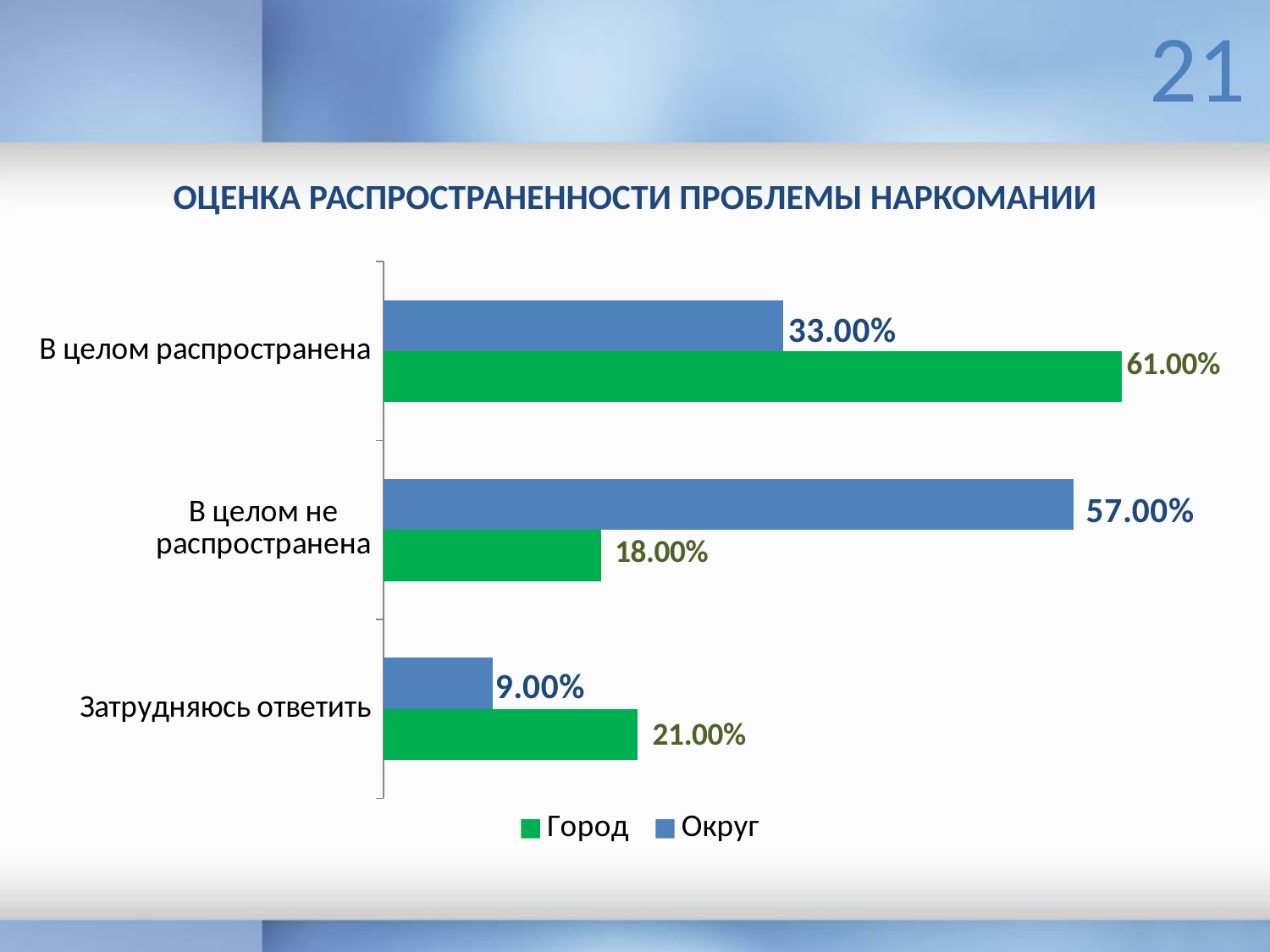
What is the value for Город in the category 'Затрудняюсь ответить'? 21.00% How many categories are shown on the chart? 3 Which category has the lowest value for the Округ series? Затрудняюсь ответить Which series has the larger value in the category 'В целом не распространена', Город or Округ? Округ What is the value for Округ in the category 'В целом не распространена'? 57.00% What kind of chart is shown on the slide? Bar chart What is the value for Город in the category 'В целом распространена'? 61.00% Which category has the highest value for the Город series? В целом распространена How many series does the legend list? 2 What is the title of the chart? ОЦЕНКА РАСПРОСТРАНЕННОСТИ ПРОБЛЕМЫ НАРКОМАНИИ What is the value for Округ in the category 'Затрудняюсь ответить'? 9.00% What is the difference between the Город and Округ values in the category 'В целом распространена'? 28.00%